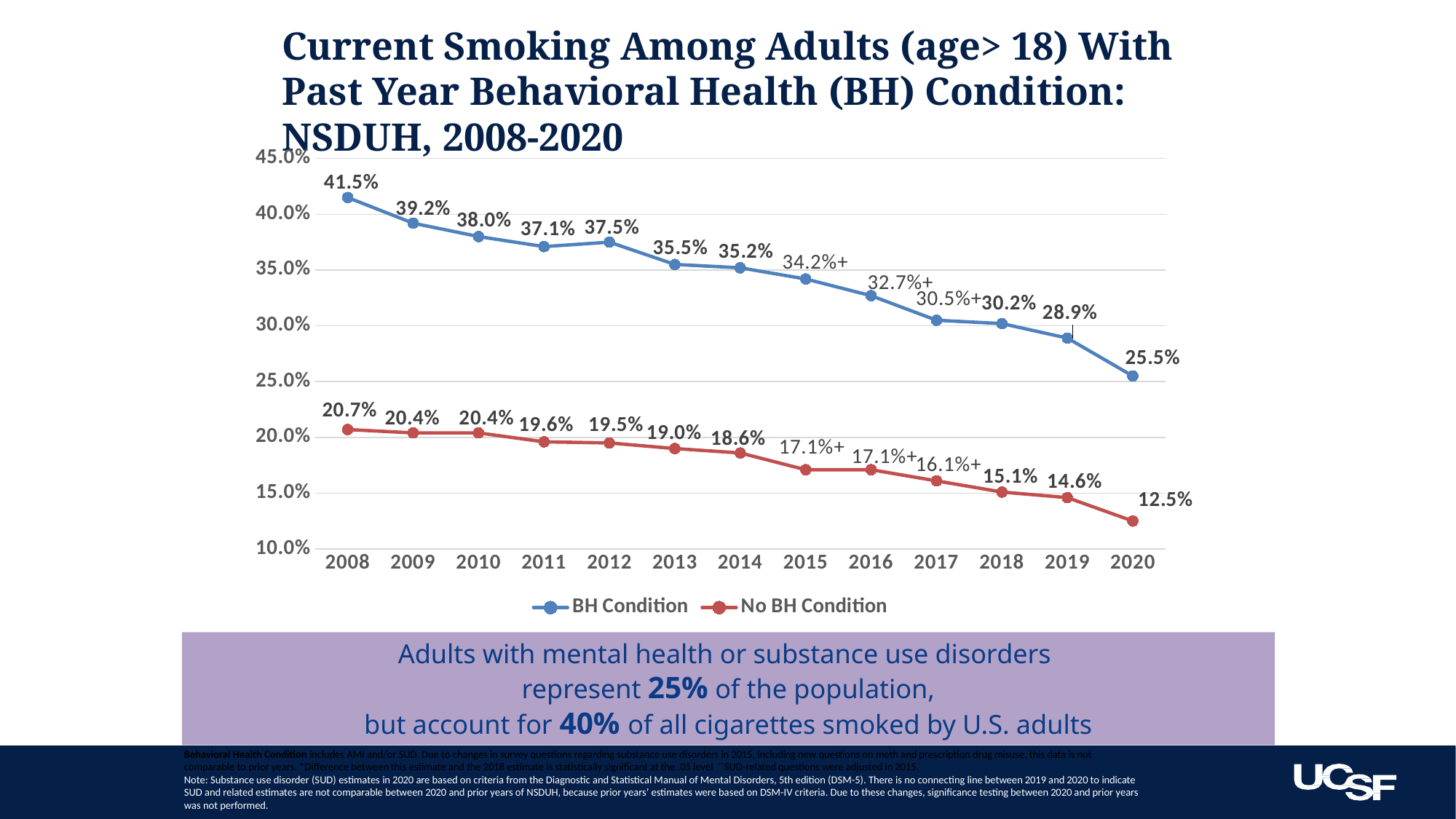
In which year is the BH Condition value lowest? 2020 How many series does the legend list? 2 What is the value for No BH Condition in 2020? 12.5% What is the value for BH Condition in 2014? 35.2% What is the difference between the BH Condition and No BH Condition values in 2020? 13.0% In which year is the No BH Condition value highest? 2008 What colour is the line for No BH Condition? Red Which is larger in 2012: the BH Condition value or the No BH Condition value? BH Condition What is the value for BH Condition in 2008? 41.5% How many years are shown on the x axis? 13 What kind of chart is shown on the slide? Line chart Does the BH Condition series generally rise or fall from 2008 to 2020? Fall